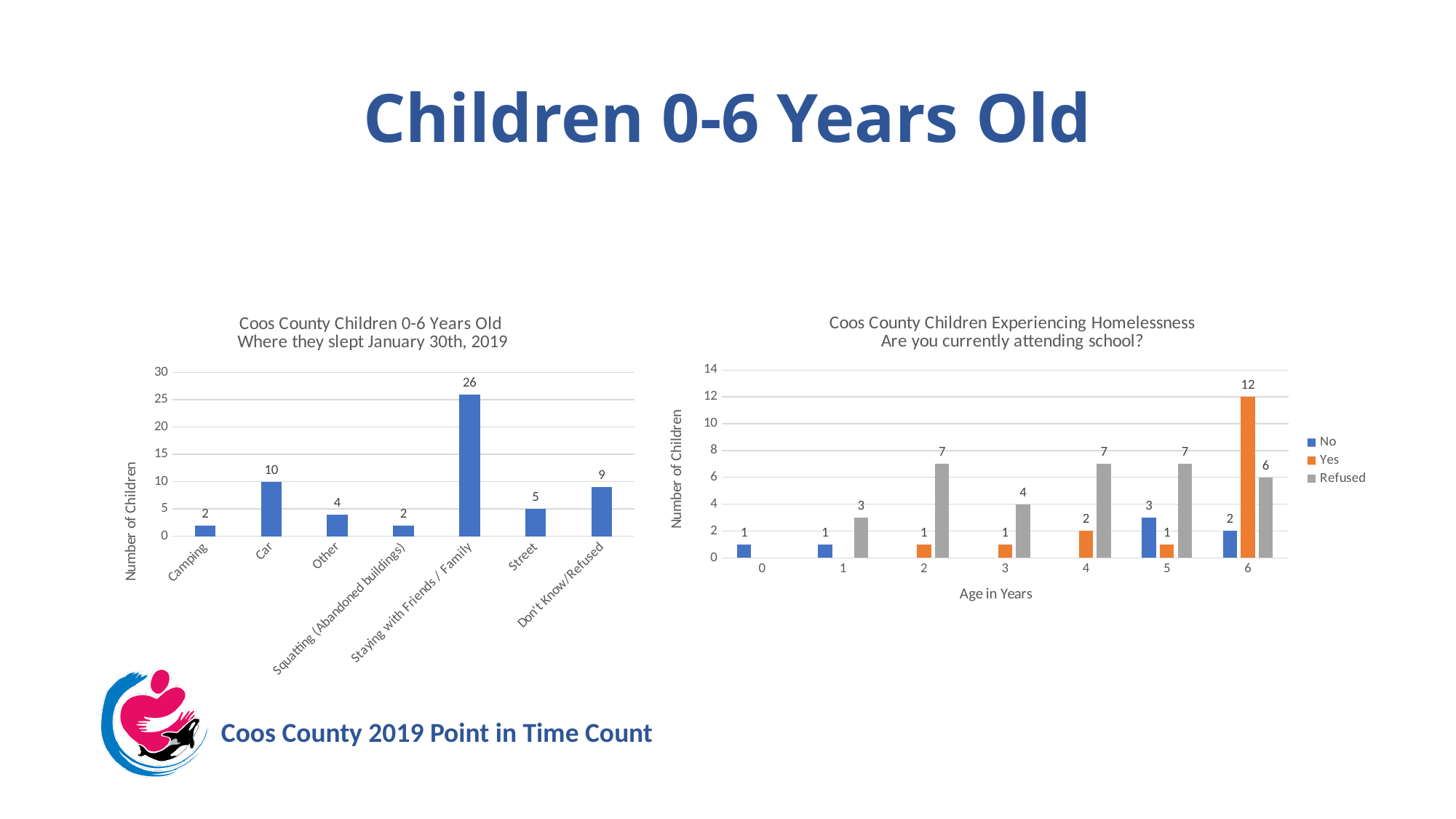
What kind of chart is the left chart (Where they slept January 30th, 2019)? Bar chart In the left chart (Where they slept January 30th, 2019), how many categories are shown on the x axis? 7 In the right chart (Are you currently attending school?), what is the x-axis title? Age in Years In the right chart (Are you currently attending school?), how many children aged 6 answered Yes? 12 In the right chart (Are you currently attending school?), how many series does the legend list? 3 In the right chart (Are you currently attending school?), which age has the highest Yes value? 6 In the left chart (Where they slept January 30th, 2019), which category has the highest number of children? Staying with Friends / Family In the left chart (Where they slept January 30th, 2019), what is the difference between the Staying with Friends / Family value and the Don't Know/Refused value? 17 In the left chart (Where they slept January 30th, 2019), which is larger: the value for Street or the value for Other? Street In the left chart (Where they slept January 30th, 2019), how many children slept in a car? 10 In the right chart (Are you currently attending school?), what is the Refused value for age 3? 4 In the right chart (Are you currently attending school?), what is the total number of children aged 5 across all three responses? 11